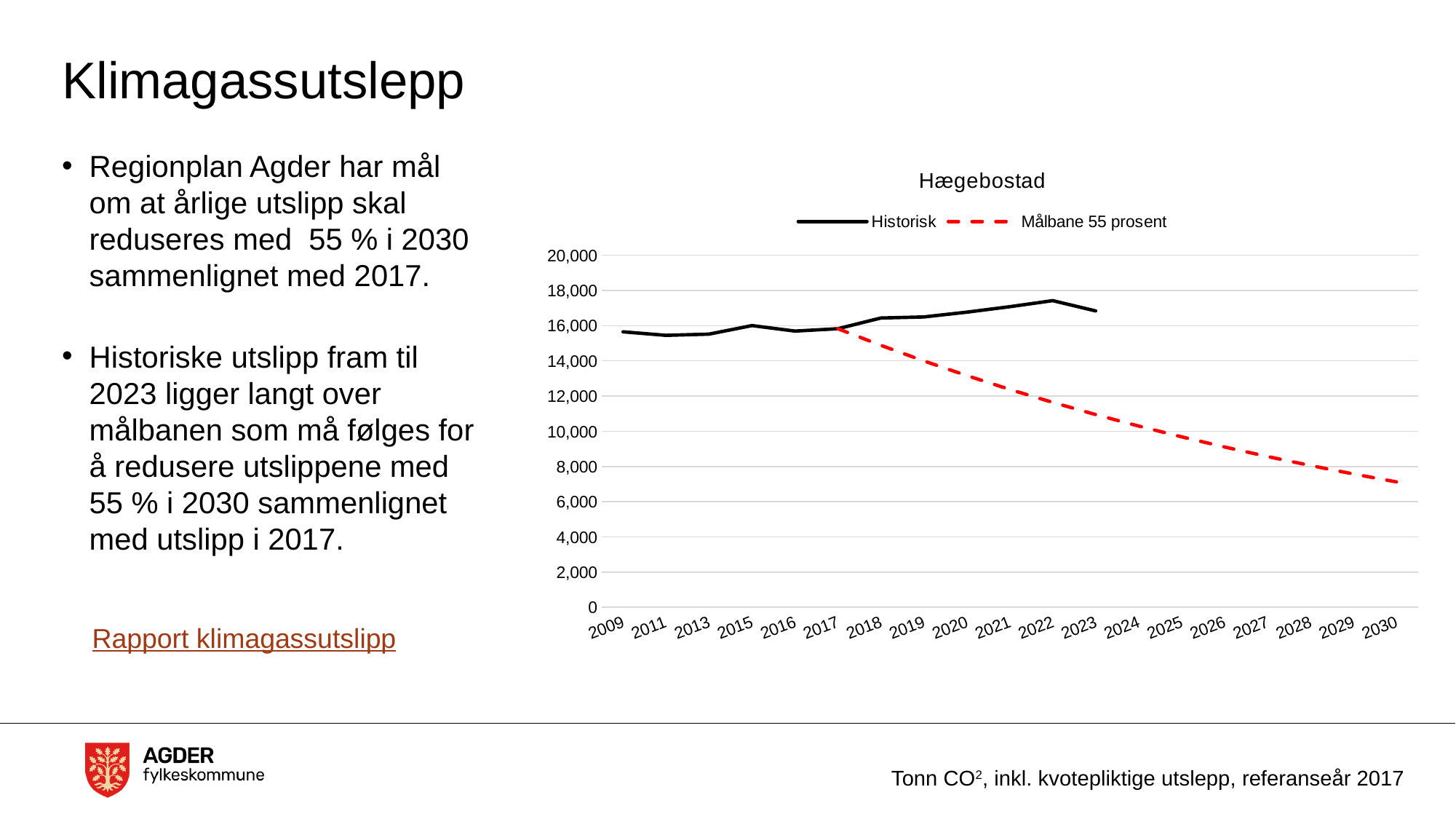
In 2023, which series has the larger value, Historisk or Målbane 55 prosent? Historisk Is the Målbane 55 prosent value for 2025 greater or less than 12,000? less In which year does the Målbane 55 prosent series reach its lowest value? 2030 What is the title of the chart? Hægebostad How many year labels are shown on the x axis? 19 How many series does the chart legend list? 2 Which series is drawn as a red dashed line? Målbane 55 prosent Does the Målbane 55 prosent series rise or fall from 2017 to 2030? fall What kind of chart is shown on the slide? line chart Is the Historisk value for 2022 greater or less than 16,000? greater Is the Målbane 55 prosent value for 2030 greater or less than 8,000? less In which year does the Historisk series reach its highest value? 2022